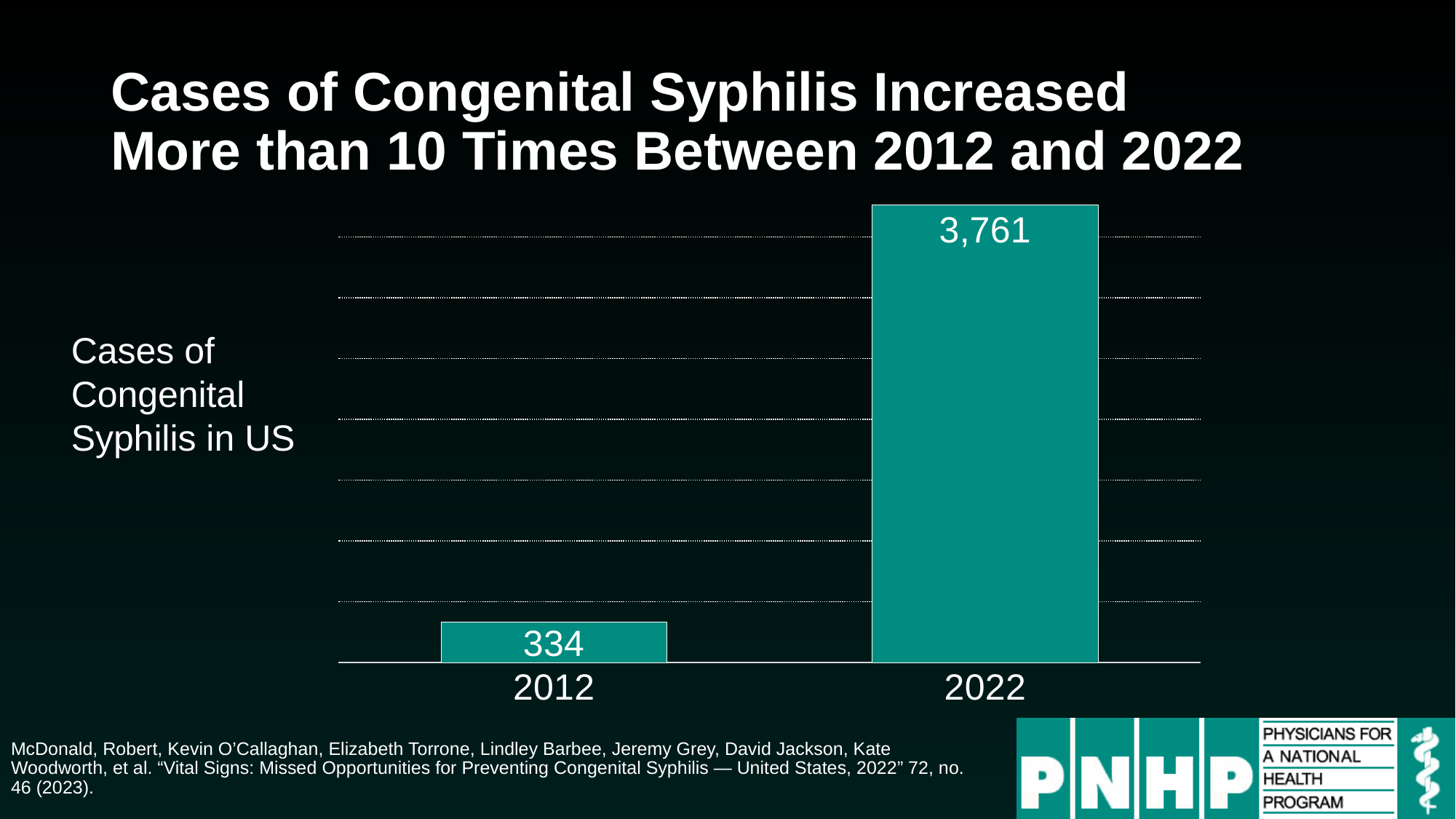
Do the values rise or fall from 2012 to 2022? rise What kind of chart is shown on the slide? bar chart What is the number of congenital syphilis cases in the US shown for 2022? 3,761 What is the title of the slide containing the chart? Cases of Congenital Syphilis Increased More than 10 Times Between 2012 and 2022 Which year has the higher number of congenital syphilis cases? 2022 Is the value for 2022 larger or smaller than the value for 2012? larger How many years (categories) are plotted in the chart? 2 What is the number of congenital syphilis cases in the US shown for 2012? 334 What label describes the quantity plotted on the chart? Cases of Congenital Syphilis in US By how much did the number of congenital syphilis cases increase from 2012 to 2022? 3,427 Which year has the lower number of congenital syphilis cases? 2012